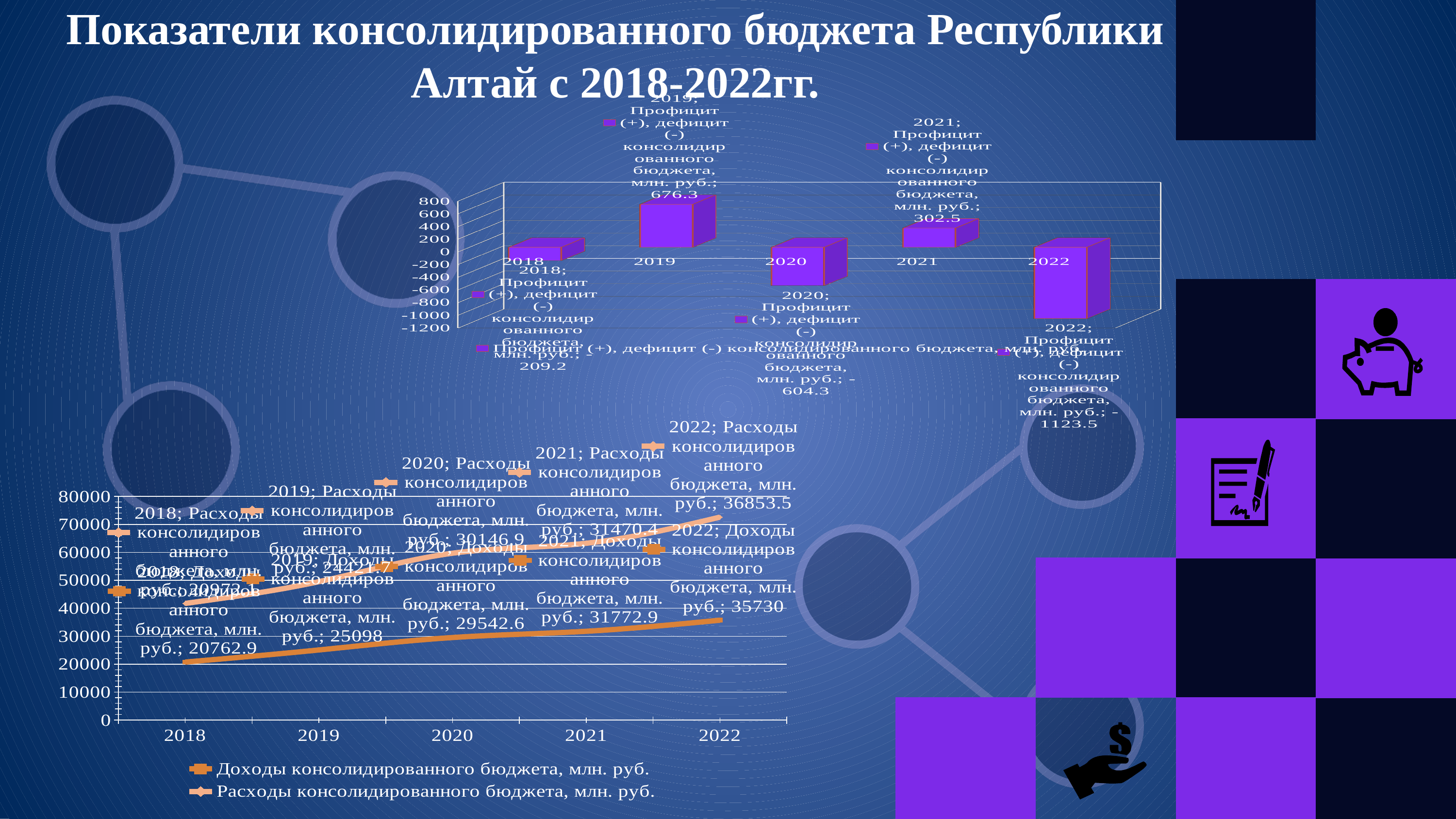
In the top chart, which year has the highest value? 2019 What kind of chart is the bottom chart on the slide? line chart In the top chart, which year has the lowest value? 2022 How many series does the legend of the bottom chart list? 2 In the top chart, is the value for 2020 greater or less than -400? less In the bottom chart, do the values of Доходы консолидированного бюджета rise or fall from 2018 to 2022? rise In the bottom chart, what is the difference between Расходы and Доходы консолидированного бюджета in 2022? 1123.5 In the top chart, what is the value of the surplus/deficit for 2022? -1123.5 How many years are plotted in the top chart? 5 In the top chart, what is the value of the surplus/deficit (Профицит (+), дефицит (-)) for 2019? 676.3 What kind of chart is the top chart on the slide? bar chart In the bottom chart, what is the value of Расходы консолидированного бюджета for 2022? 36853.5